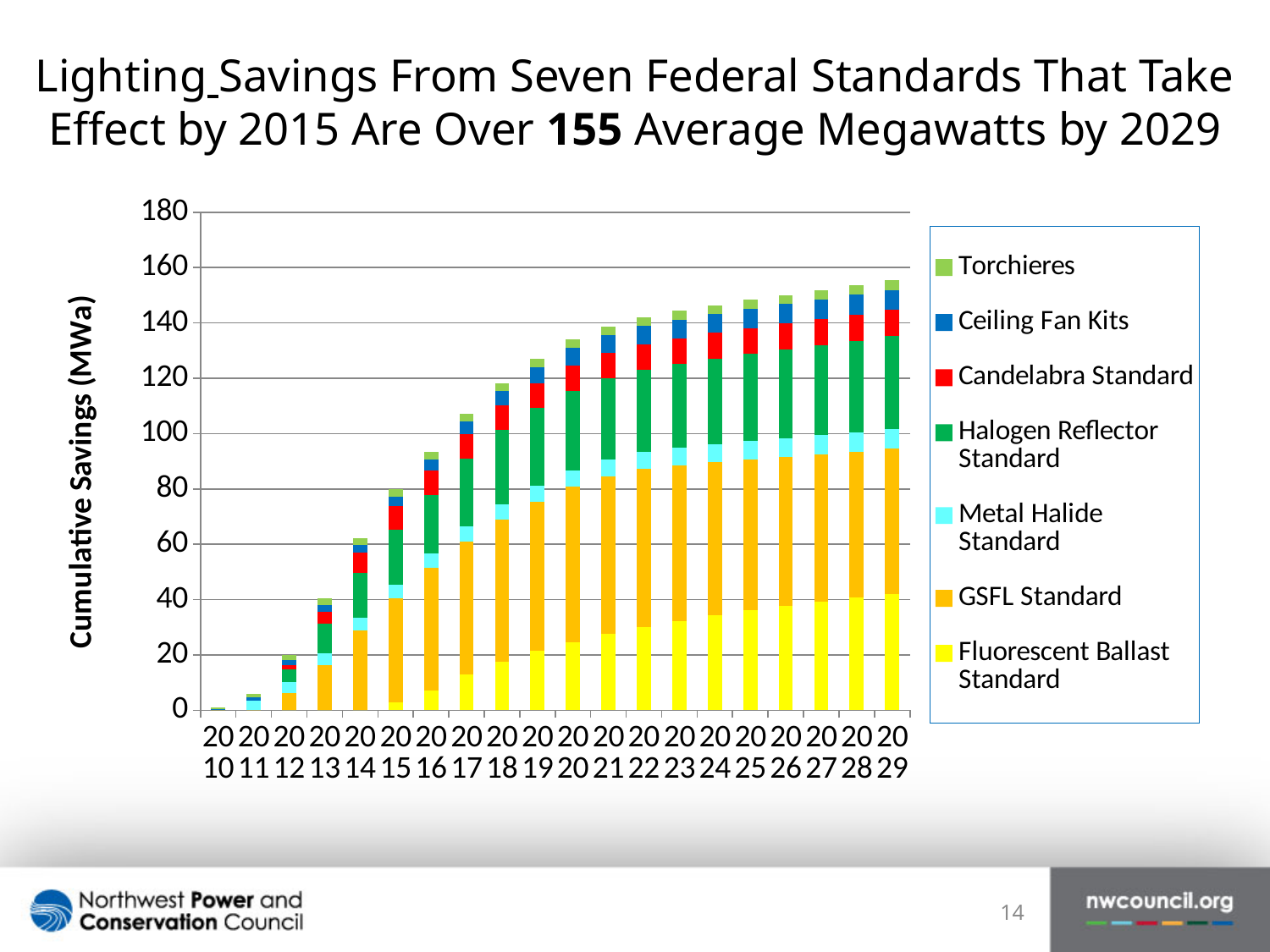
Which year has a larger total cumulative savings, 2015 or 2020? 2020 Is the total cumulative savings for 2012 greater or less than 40? less What is the label on the y axis? Cumulative Savings (MWa) Which year has the highest total cumulative savings? 2029 Which year has the lowest total cumulative savings? 2010 Which series is shown in yellow at the bottom of each bar? Fluorescent Ballast Standard How many series does the legend list? 7 How many years are shown along the x axis? 20 Do the total cumulative savings rise or fall from 2010 to 2029? Rise What kind of chart is shown on the slide? Stacked bar chart Is the total cumulative savings for 2020 greater or less than 120? greater Is the total cumulative savings for 2029 greater or less than 140? greater